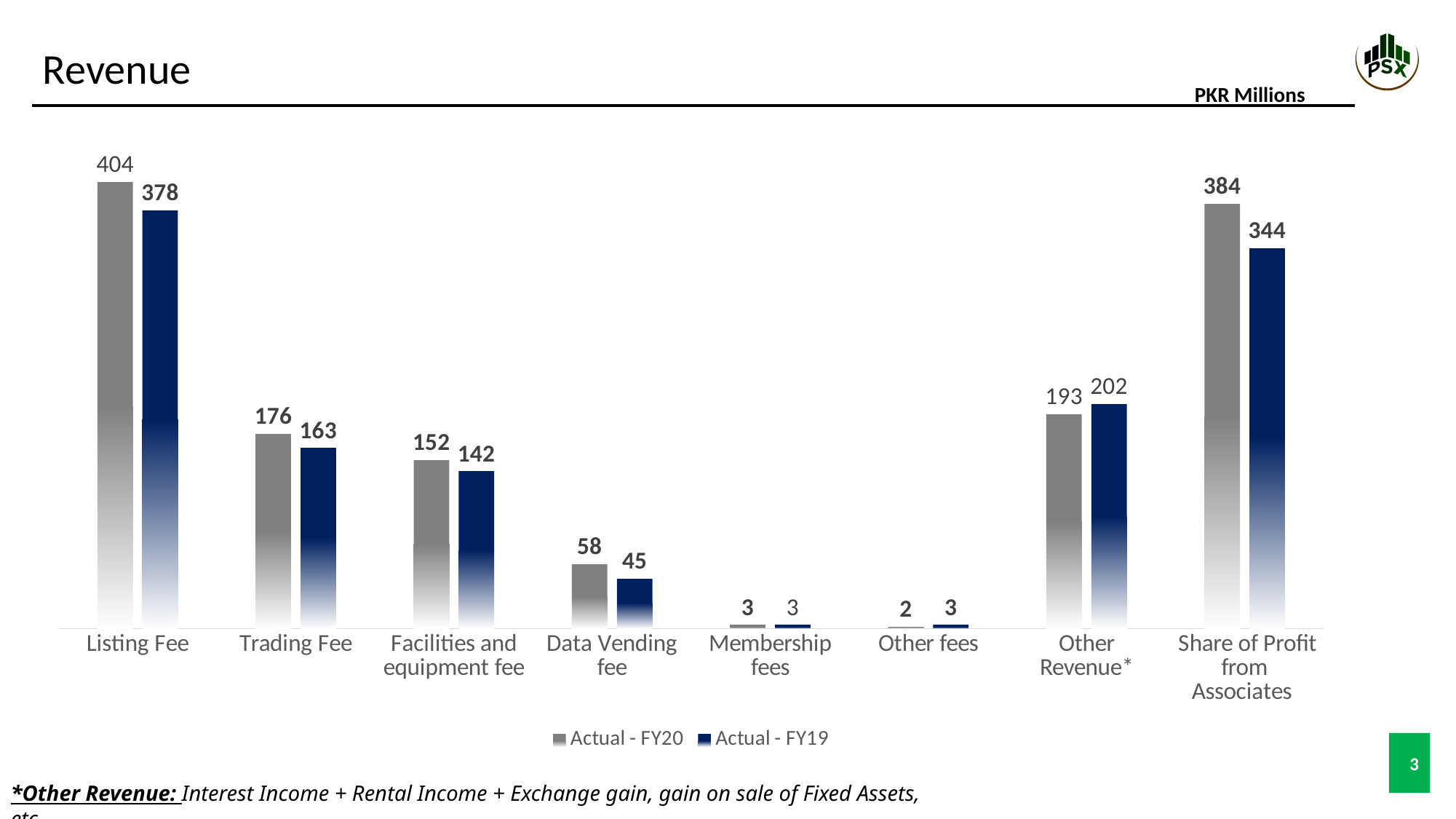
Which category has the highest Actual - FY20 value? Listing Fee What is the difference between the Actual - FY20 and Actual - FY19 values for Trading Fee? 13 What is the Actual - FY20 value for Data Vending fee? 58 How many series does the legend list? 2 What kind of chart is shown on the slide? Bar chart What is the Actual - FY19 value for Share of Profit from Associates? 344 What unit is stated for the values in the chart? PKR Millions What is the difference between the Actual - FY20 values for Listing Fee and Share of Profit from Associates? 20 Which category has the lowest Actual - FY20 value? Other fees For Other Revenue, which is larger: Actual - FY20 or Actual - FY19? Actual - FY19 How many categories are shown on the x axis? 8 What is the Actual - FY20 value for Listing Fee? 404